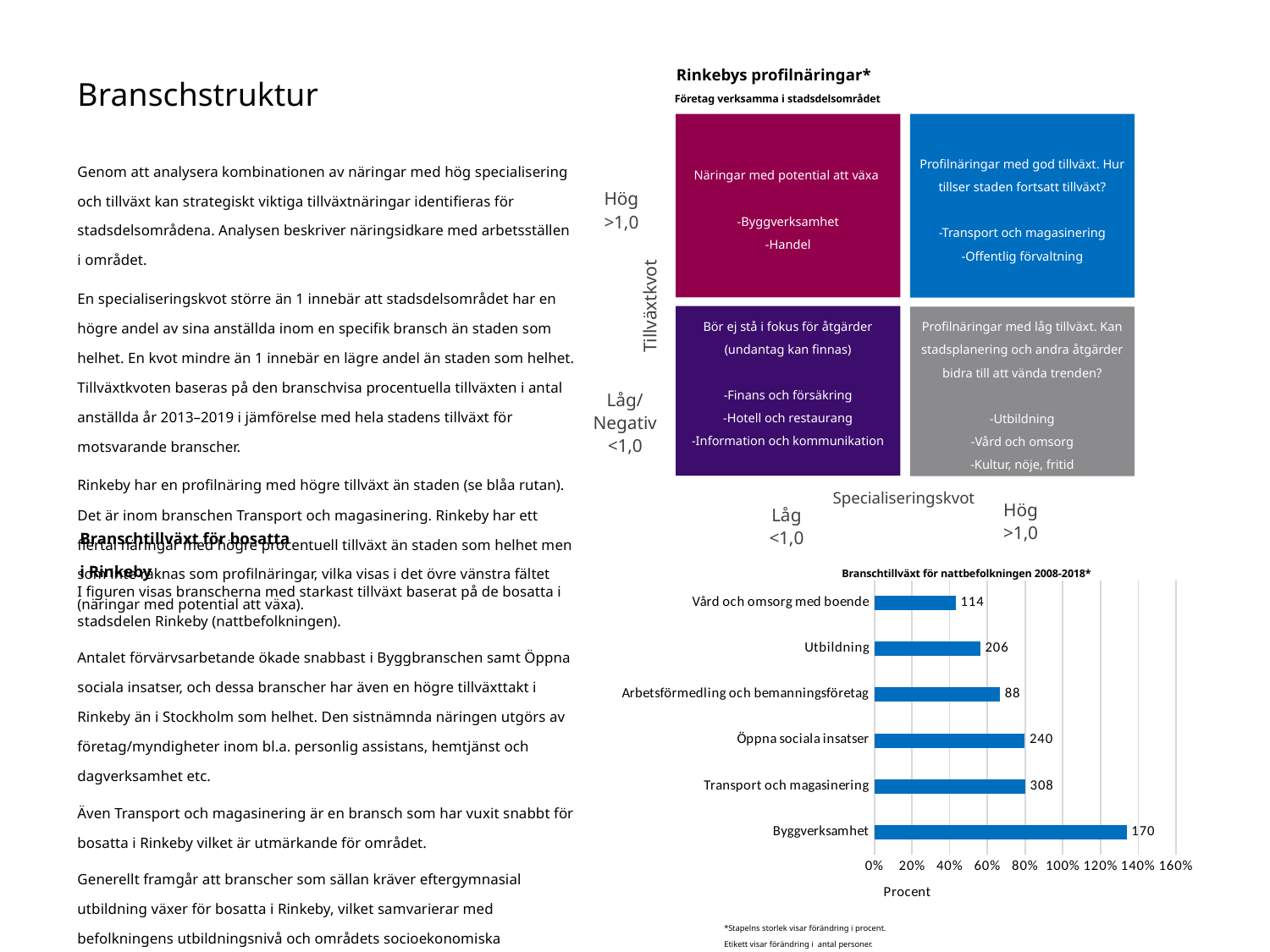
In the chart 'Branschtillväxt för nattbefolkningen 2008-2018*', which category has the longest bar (highest percentage change)? Byggverksamhet What is the title of the horizontal axis in the chart 'Branschtillväxt för nattbefolkningen 2008-2018*'? Procent In the chart 'Branschtillväxt för nattbefolkningen 2008-2018*', is the percentage change for Transport och magasinering greater or less than 100%? less In the chart 'Branschtillväxt för nattbefolkningen 2008-2018*', what is the difference between the printed labels for Transport och magasinering and Öppna sociala insatser? 68 In the chart 'Branschtillväxt för nattbefolkningen 2008-2018*', which category has the shortest bar (lowest percentage change)? Vård och omsorg med boende In the chart 'Branschtillväxt för nattbefolkningen 2008-2018*', what number is printed next to the bar for Arbetsförmedling och bemanningsföretag? 88 How many categories are shown in the chart 'Branschtillväxt för nattbefolkningen 2008-2018*'? 6 In the chart 'Branschtillväxt för nattbefolkningen 2008-2018*', what number is printed next to the bar for Utbildning? 206 What kind of chart is 'Branschtillväxt för nattbefolkningen 2008-2018*'? bar chart In the chart 'Branschtillväxt för nattbefolkningen 2008-2018*', which has the larger printed label: Öppna sociala insatser or Byggverksamhet? Öppna sociala insatser In the chart 'Branschtillväxt för nattbefolkningen 2008-2018*', what number is printed next to the bar for Transport och magasinering? 308 In the chart 'Branschtillväxt för nattbefolkningen 2008-2018*', is the percentage change for Byggverksamhet greater or less than 120%? greater